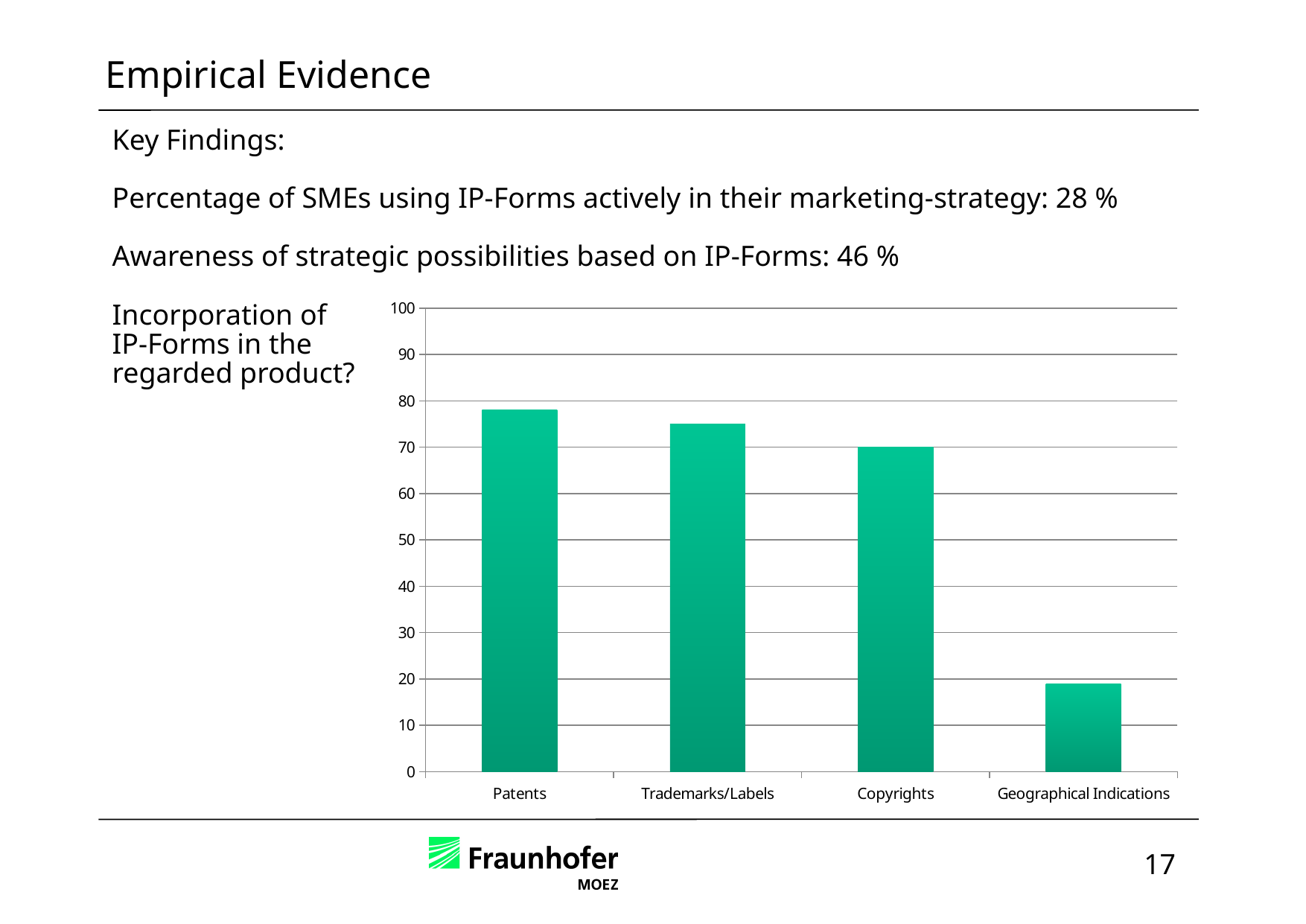
Which is larger, the value for Patents or the value for Copyrights? Patents Which is larger, the value for Trademarks/Labels or the value for Geographical Indications? Trademarks/Labels Is the value for Trademarks/Labels greater or less than 70? greater How many categories are shown on the x axis of the chart? 4 Is the value for Patents greater or less than 70? greater Is the value for Geographical Indications greater or less than 30? less Which category has the lowest bar in the chart? Geographical Indications What kind of chart is shown on the slide? bar chart Do the bar values rise or fall from left to right across the x axis? fall What is the maximum value shown on the chart's y axis? 100 Which category has the highest bar in the chart? Patents